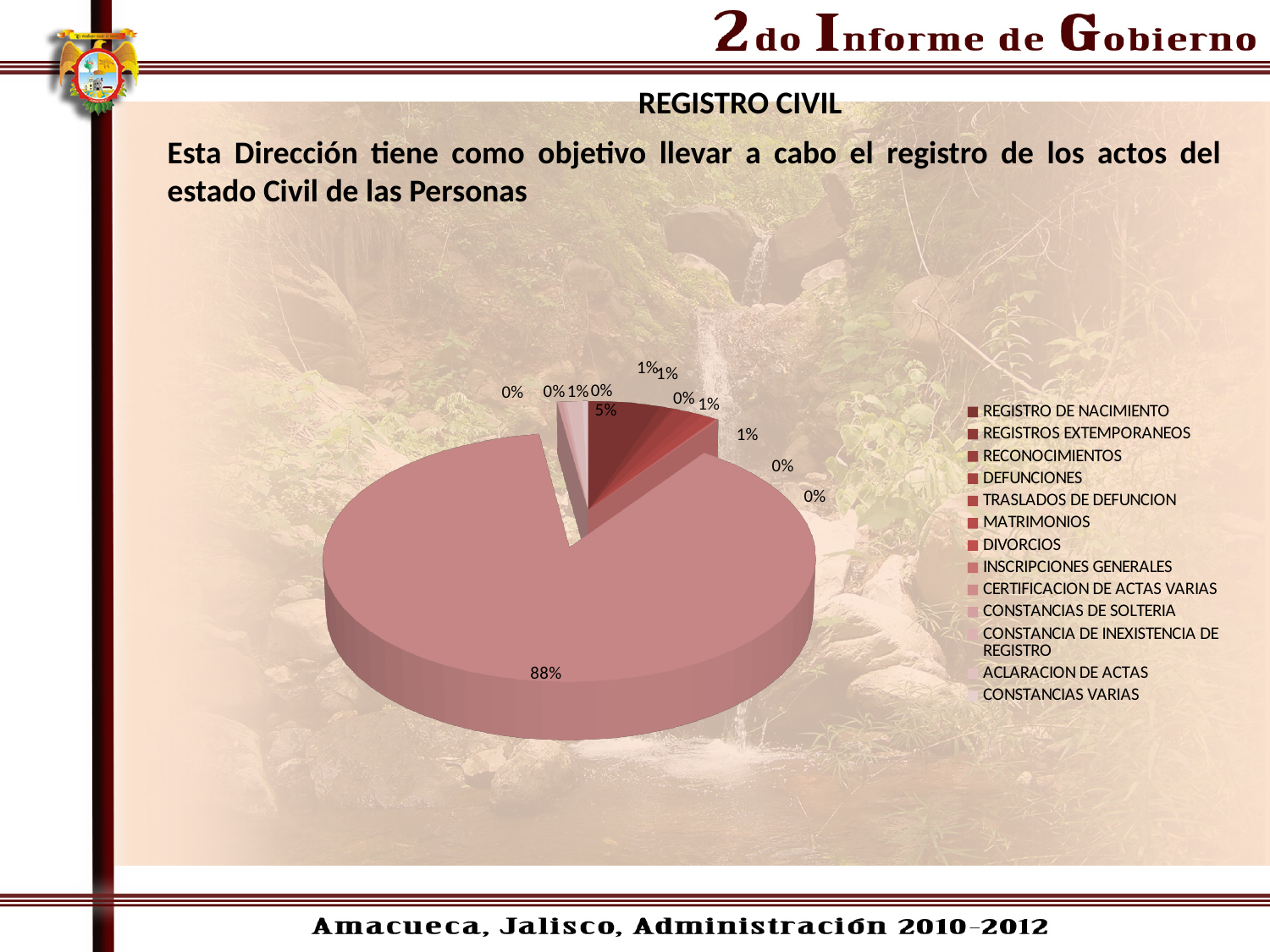
What is the last entry listed in the legend of the pie chart? CONSTANCIAS VARIAS How many categories does the legend of the pie chart list? 13 What is the difference between the largest slice (88%) and the second largest slice (5%) of the pie chart? 83% What is the second largest share labelled on the pie chart? 5% What is the largest share shown on the pie chart? 88% What is the first entry listed in the legend of the pie chart? REGISTRO DE NACIMIENTO What kind of chart is shown on the slide? pie chart Which is larger on the pie chart, the slice labelled 88% or the slice labelled 5%? the slice labelled 88% Is the largest slice of the pie chart greater or less than 50%? greater